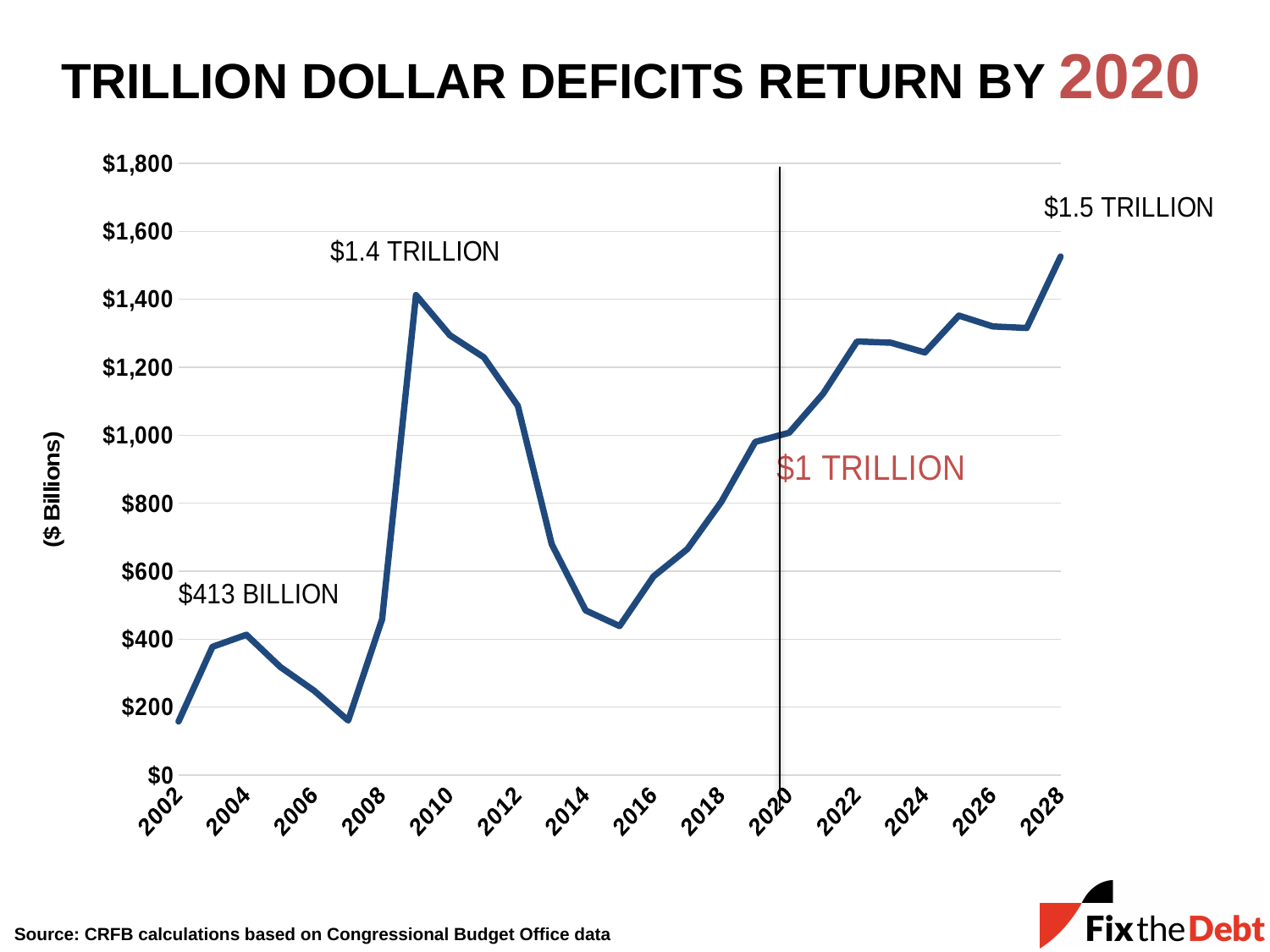
What is the label on the vertical axis? ($ Billions) Does the line generally rise or fall between 2020 and 2028? rise Which is larger, the value for 2012 or the value for 2022? 2022 Is the value for 2025 greater or less than $1,200? greater What value is annotated at the 2009 peak of the line? $1.4 TRILLION In which year does the line reach its highest value? 2028 What value is annotated at the end of the line in 2028? $1.5 TRILLION Is the value for 2007 greater or less than $200? less What value is annotated near the early peak around 2004? $413 BILLION What kind of chart is shown on the slide? line chart What value is annotated at the vertical line marking 2020? $1 TRILLION What is the title of the chart? TRILLION DOLLAR DEFICITS RETURN BY 2020